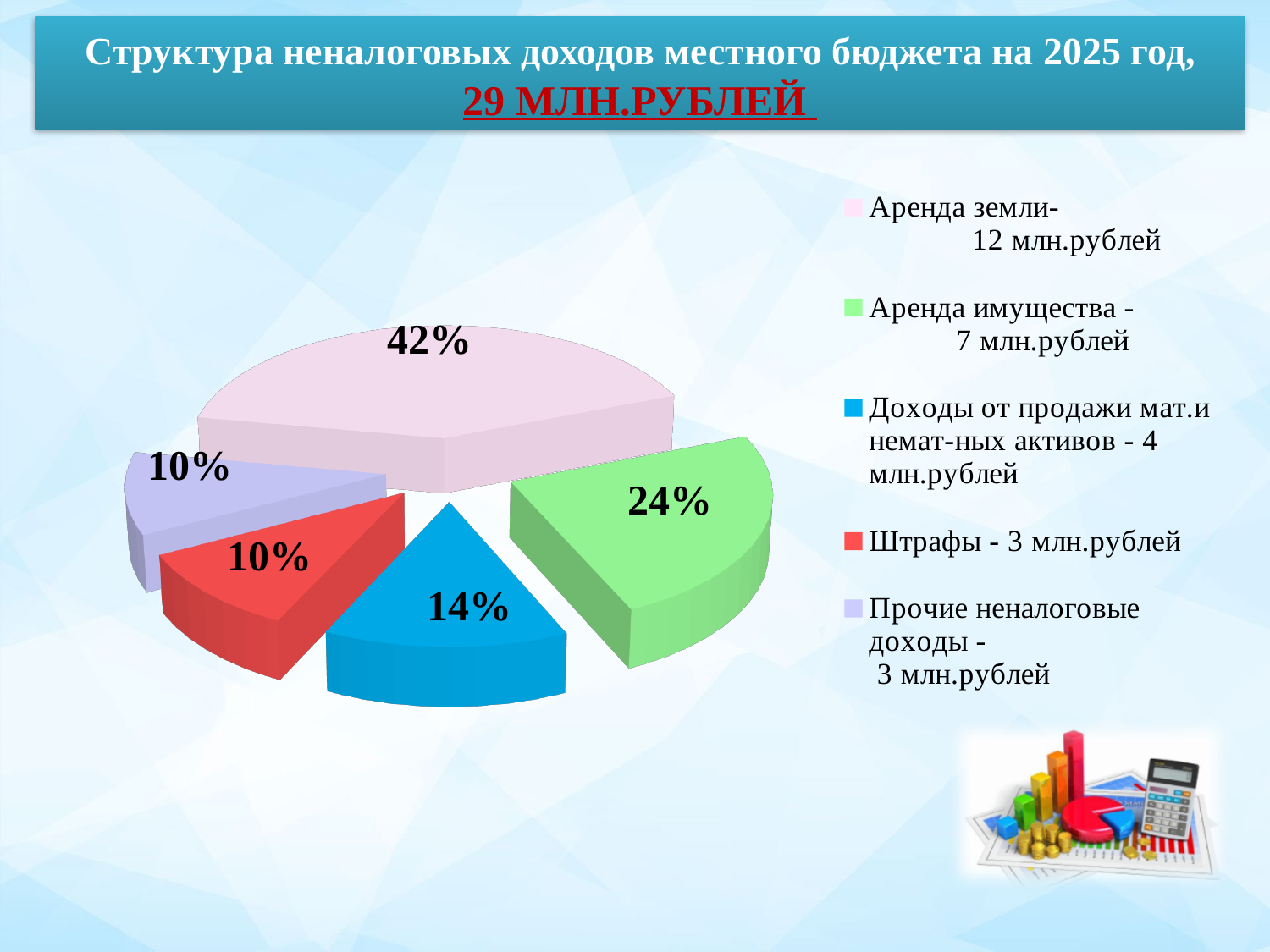
Which slice is larger: "Аренда имущества" or "Доходы от продажи мат.и немат-ных активов"? Аренда имущества What share of the pie does "Аренда имущества" take? 24% What total amount in million rubles is stated in the chart title? 29 МЛН.РУБЛЕЙ What kind of chart is shown on the slide? Pie chart According to the legend, how many million rubles does "Штрафы" amount to? 3 млн.рублей According to the legend, how many million rubles does "Аренда земли" amount to? 12 млн.рублей What share of the pie does "Аренда земли" take? 42% Which category has the largest slice of the pie? Аренда земли What is the difference in percentage points between the "Аренда земли" slice and the "Аренда имущества" slice? 18 What share of the pie does "Доходы от продажи мат.и немат-ных активов" take? 14% How many slices does the pie chart have? 5